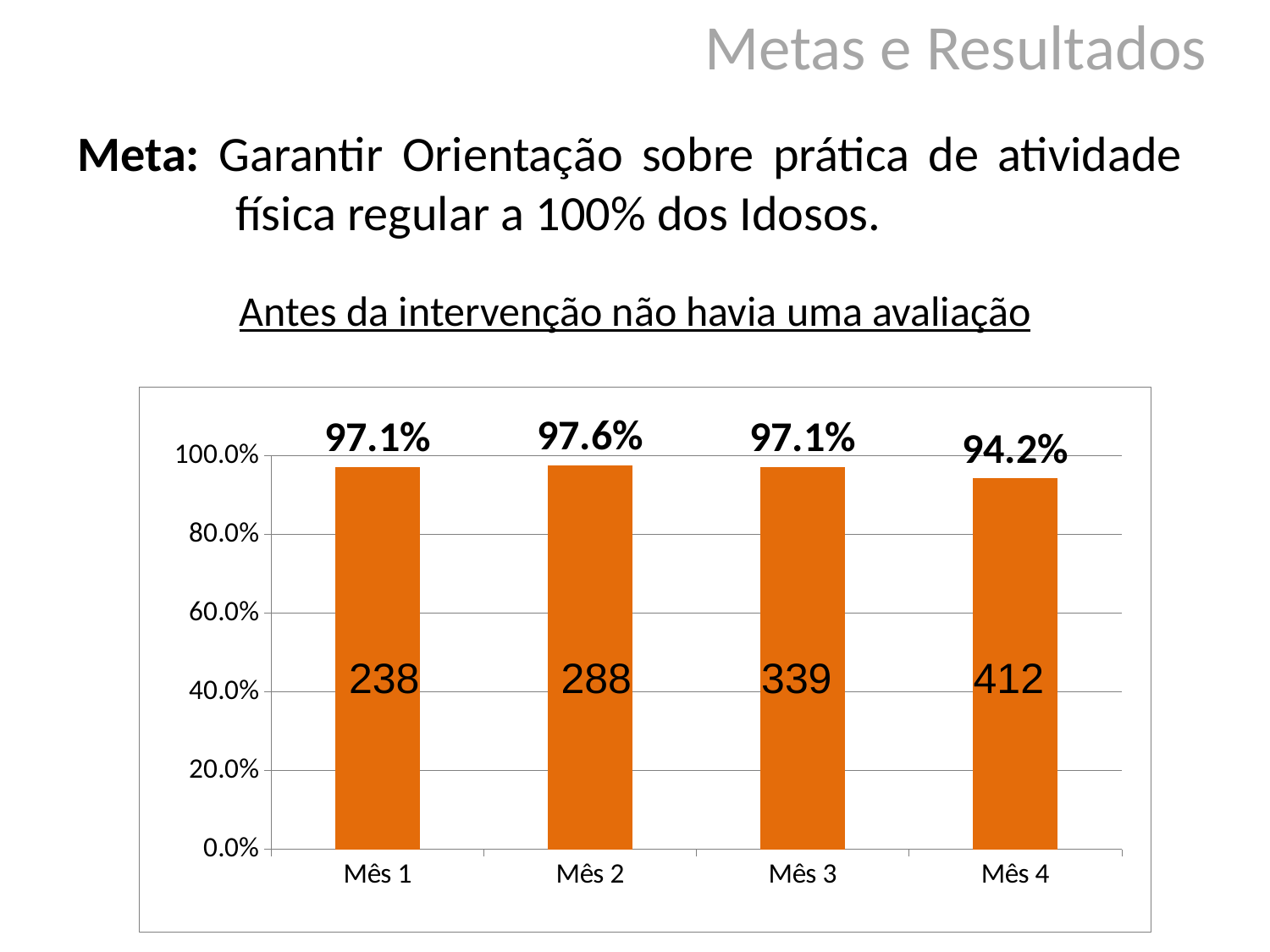
What number is printed inside the bar for Mês 3? 339 What type of chart is shown on the slide? Bar chart Which month has the lowest percentage? Mês 4 Do the numbers printed inside the bars rise or fall from Mês 1 to Mês 4? Rise Which has a higher percentage, Mês 2 or Mês 4? Mês 2 What number is printed inside the bar for Mês 1? 238 What percentage is shown for Mês 2? 97.6% What percentage is shown for Mês 4? 94.2% Which month has the highest percentage? Mês 2 What is the difference in percentage points between Mês 2 and Mês 4? 3.4 How many months are shown on the x axis? 4 What is the difference between the numbers printed inside the bars for Mês 4 and Mês 1? 174